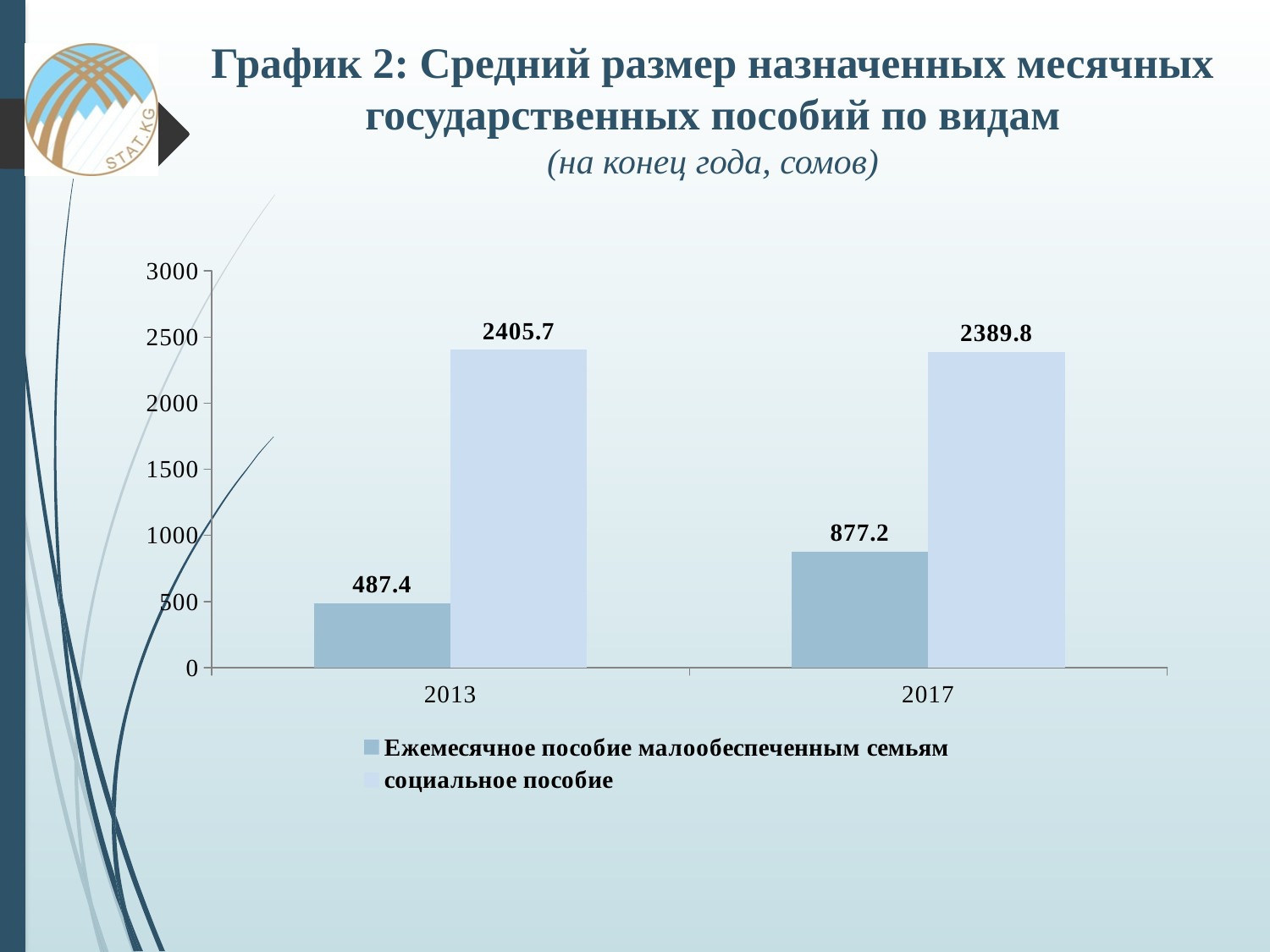
What is the value of Ежемесячное пособие малообеспеченным семьям in 2013? 487.4 How many years are shown on the x axis? 2 What is the value of Ежемесячное пособие малообеспеченным семьям in 2017? 877.2 In which year is Ежемесячное пособие малообеспеченным семьям highest? 2017 Which is larger in 2013: социальное пособие or Ежемесячное пособие малообеспеченным семьям? социальное пособие By how much did Ежемесячное пособие малообеспеченным семьям increase from 2013 to 2017? 389.8 What is the value of социальное пособие in 2013? 2405.7 What kind of chart is shown on the slide? bar chart What is the difference between социальное пособие and Ежемесячное пособие малообеспеченным семьям in 2017? 1512.6 What is the value of социальное пособие in 2017? 2389.8 How many series does the legend list? 2 Is the value for Ежемесячное пособие малообеспеченным семьям in 2017 greater or less than 1000? less